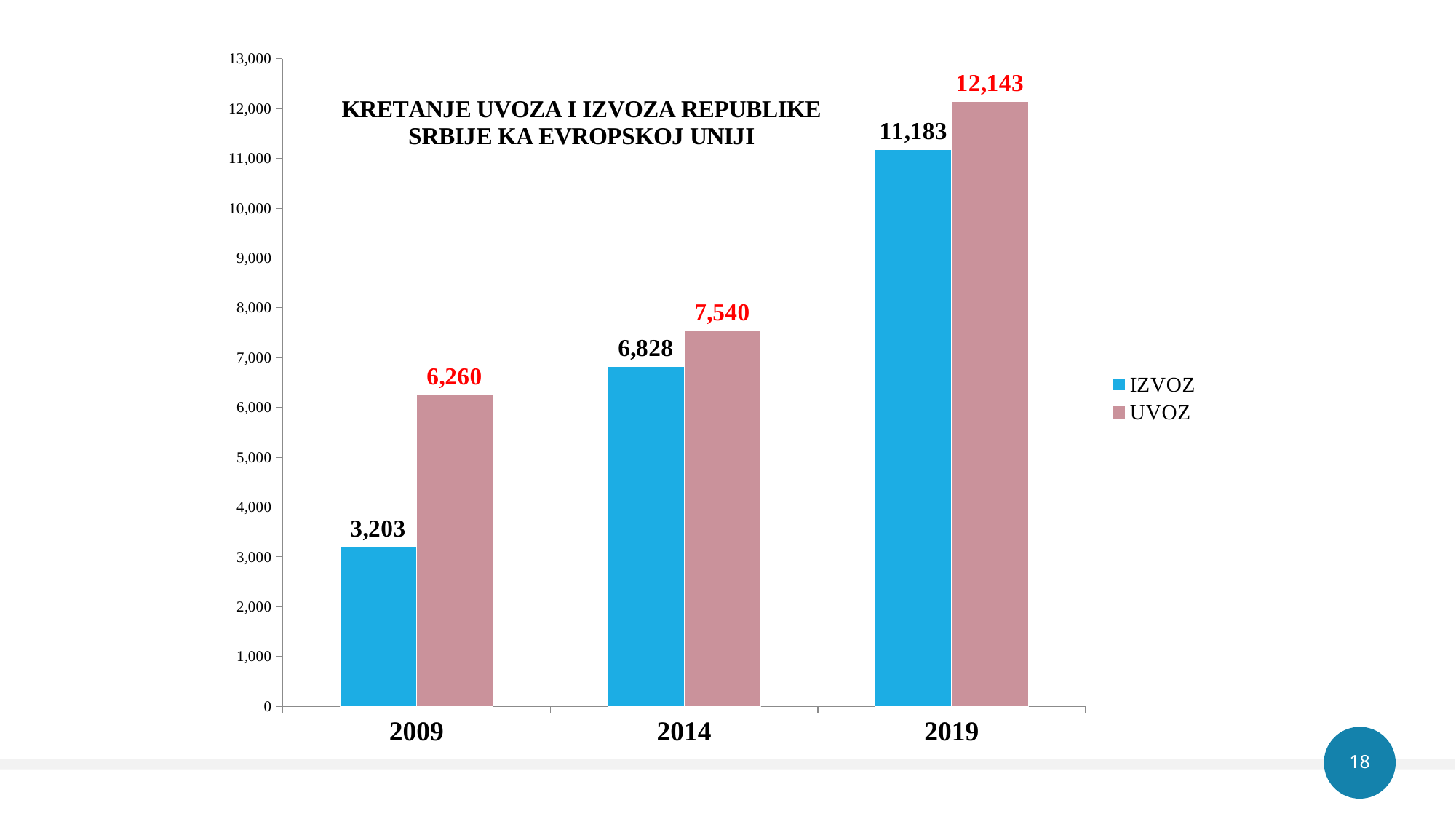
What is the IZVOZ value for 2014? 6,828 In which year is IZVOZ lowest? 2009 What is the difference between UVOZ and IZVOZ in 2009? 3,057 In which year is UVOZ highest? 2019 How many years are shown on the x axis? 3 What kind of chart is shown on the slide? Bar chart What is the IZVOZ value for 2009? 3,203 What is the UVOZ value for 2019? 12,143 Which is larger in 2014, IZVOZ or UVOZ? UVOZ What is the difference between UVOZ and IZVOZ in 2019? 960 How many series does the legend list? 2 Do the IZVOZ values rise or fall from 2009 to 2019? Rise